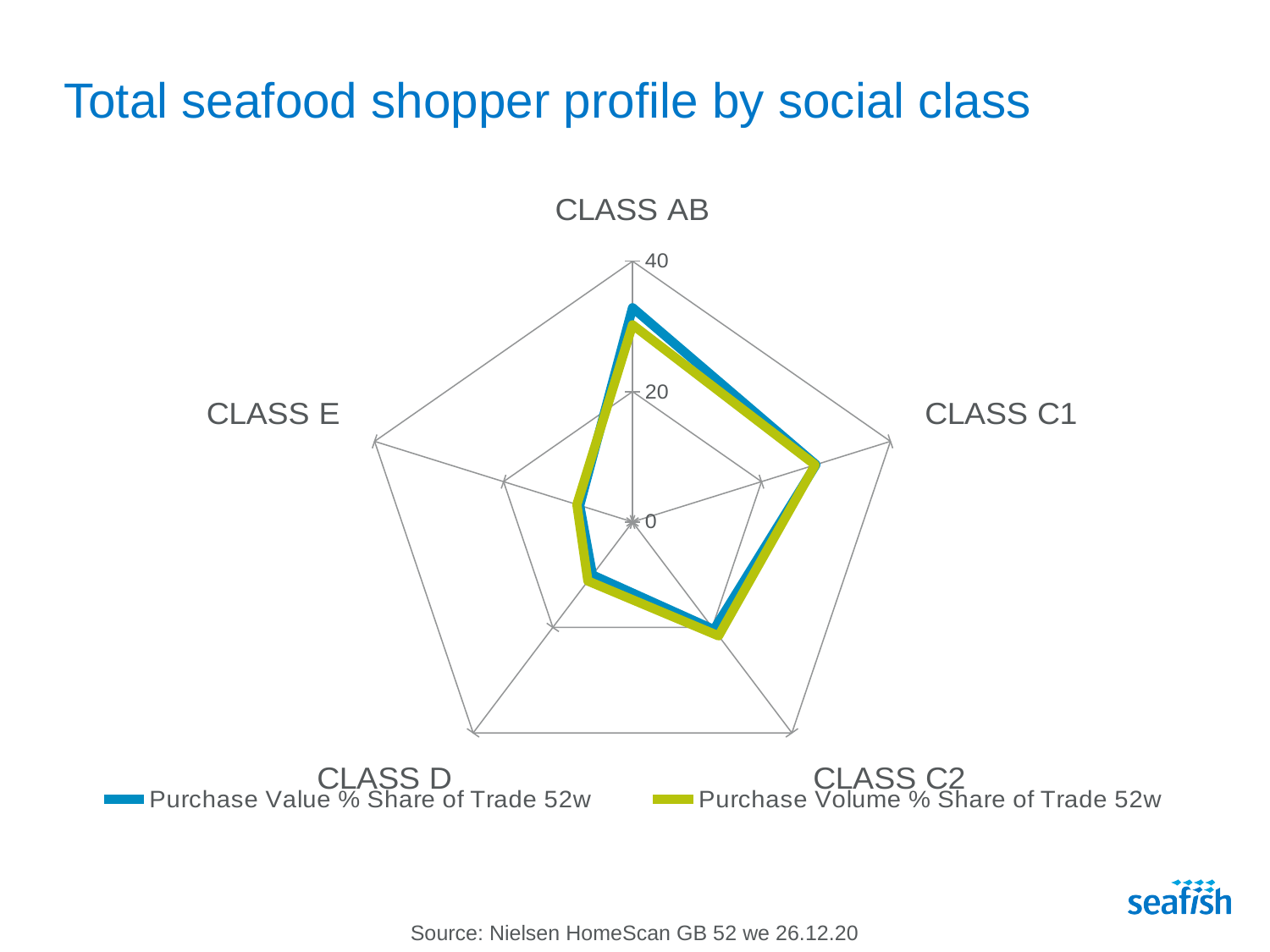
How many series does the legend list? 2 What is the title of the chart on the slide? Total seafood shopper profile by social class Is the Purchase Value % Share of Trade 52w for CLASS D greater or less than 20? less Is the Purchase Volume % Share of Trade 52w for CLASS C1 greater or less than 20? greater How many social class categories are plotted on the radar chart? 5 Which has the larger Purchase Value % Share of Trade 52w, CLASS AB or CLASS D? CLASS AB Which social class has the highest Purchase Value % Share of Trade 52w? CLASS AB What kind of chart is shown on the slide? Radar chart Which social class has the highest Purchase Volume % Share of Trade 52w? CLASS AB Is the Purchase Volume % Share of Trade 52w for CLASS E greater or less than 20? less Which series is shown in green on the radar chart? Purchase Volume % Share of Trade 52w